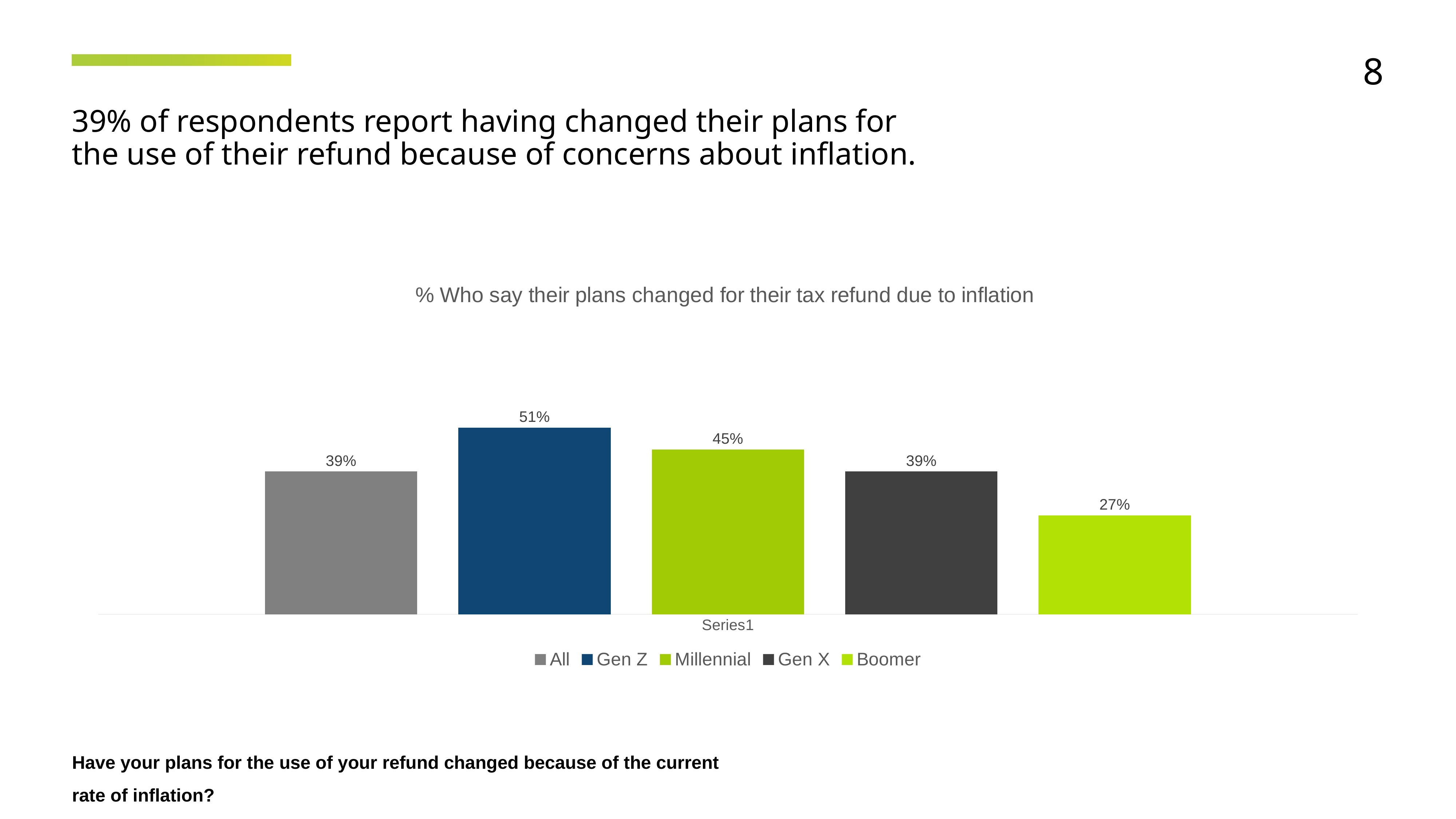
What is the value for Gen X? 39% Which group has the highest value? Gen Z What is the value for Gen Z? 51% Which group has the lowest value? Boomer What is the difference between the Millennial and Gen X values? 6% What kind of chart is shown? Bar chart How many series does the legend list? 5 What is the title of the chart? % Who say their plans changed for their tax refund due to inflation What is the difference between the Gen Z and Boomer values? 24% What is the value for Boomer? 27% What is the value for Millennial? 45% Which is larger, the value for Millennial or the value for Boomer? Millennial